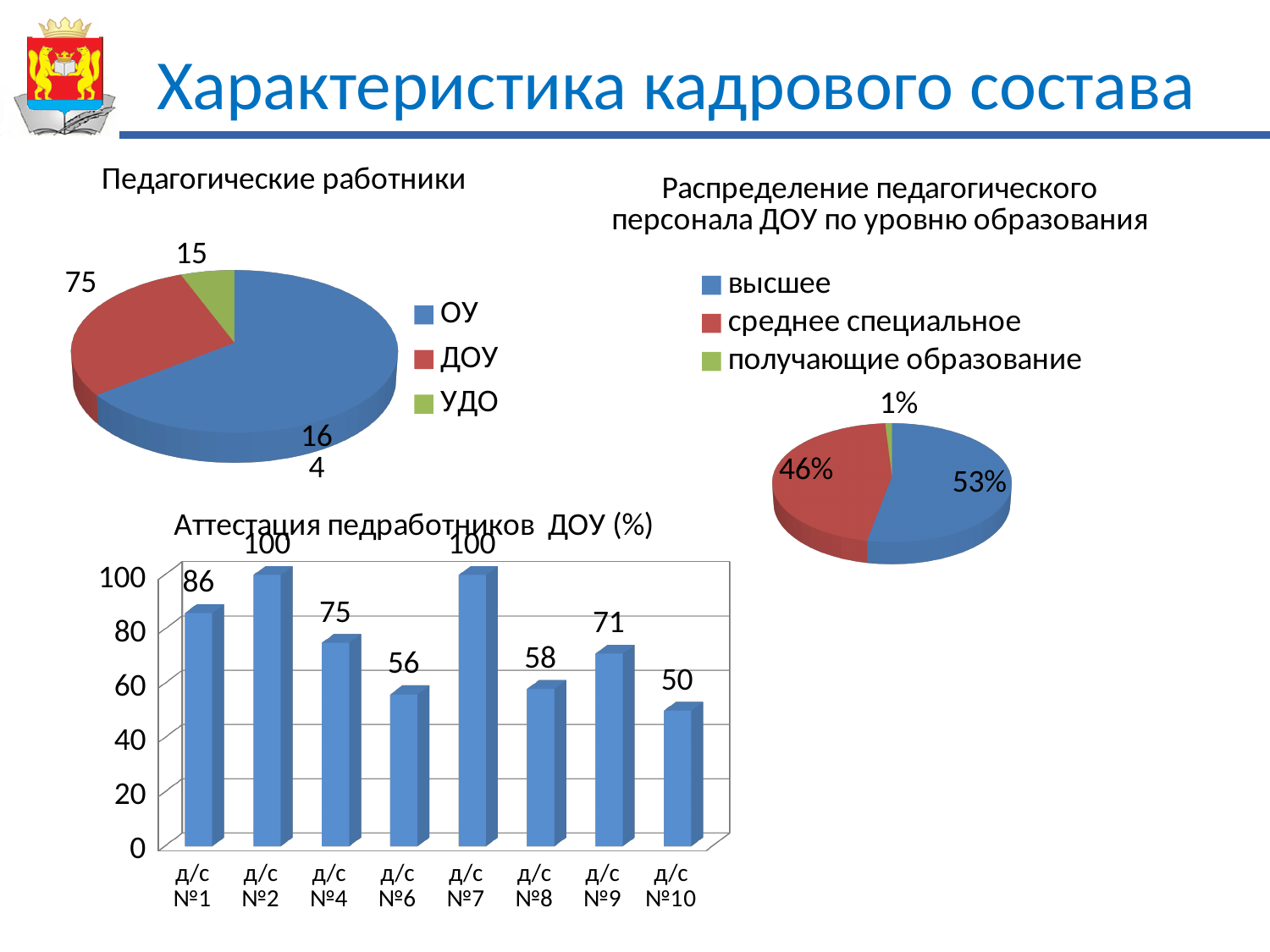
In the chart titled "Педагогические работники", what is the value for ДОУ? 75 In the chart titled "Аттестация педработников ДОУ (%)", which is larger, д/с №4 or д/с №8? д/с №4 In the chart titled "Распределение педагогического персонала ДОУ по уровню образования", how many categories does the legend list? 3 In the chart titled "Педагогические работники", what is the value for УДО? 15 In the chart titled "Педагогические работники", which category has the largest slice? ОУ In the chart titled "Распределение педагогического персонала ДОУ по уровню образования", what share is labelled for среднее специальное? 46% In the chart titled "Аттестация педработников ДОУ (%)", what is the value for д/с №9? 71 In the chart titled "Аттестация педработников ДОУ (%)", which category has the lowest value? д/с №10 In the chart titled "Распределение педагогического персонала ДОУ по уровню образования", which category has the smallest share? получающие образование In the chart titled "Аттестация педработников ДОУ (%)", how many categories are shown on the x axis? 8 In the chart titled "Аттестация педработников ДОУ (%)", what is the difference between д/с №1 and д/с №6? 30 What kind of chart is the one titled "Аттестация педработников ДОУ (%)"? bar chart